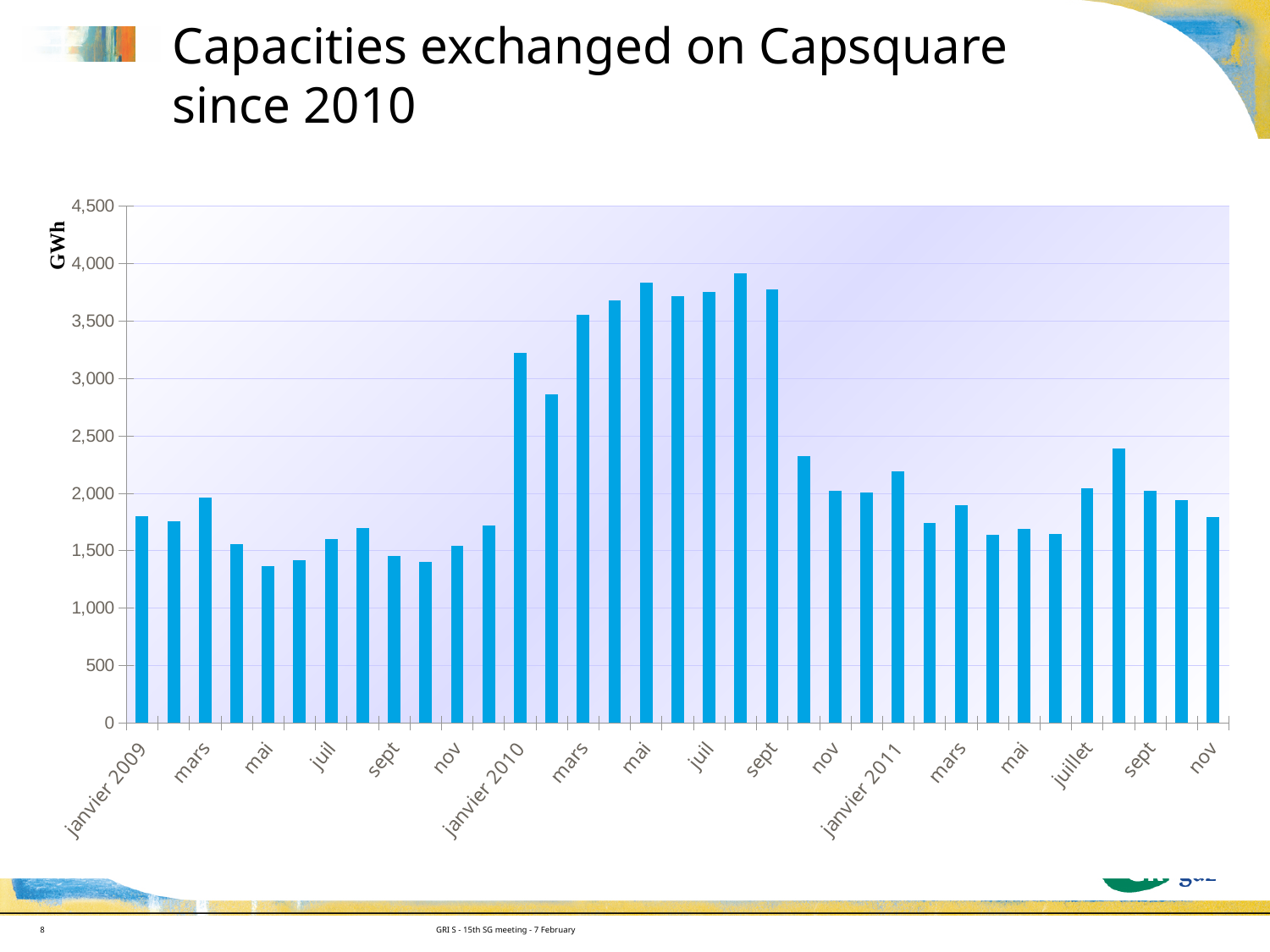
What unit is shown on the vertical axis of the chart? GWh Is the value for mai 2010 greater or less than 3,500? greater Is the value for janvier 2010 greater or less than 3,000? greater What kind of chart is shown on the slide? bar chart Do the values rise or fall from sept 2010 to nov 2010? fall Is the value for mai 2011 greater or less than 2,000? less Which is larger, the value for janvier 2010 or the value for janvier 2009? janvier 2010 Which is larger, the value for sept 2010 or the value for sept 2011? sept 2010 What is the title of the slide's chart? Capacities exchanged on Capsquare since 2010